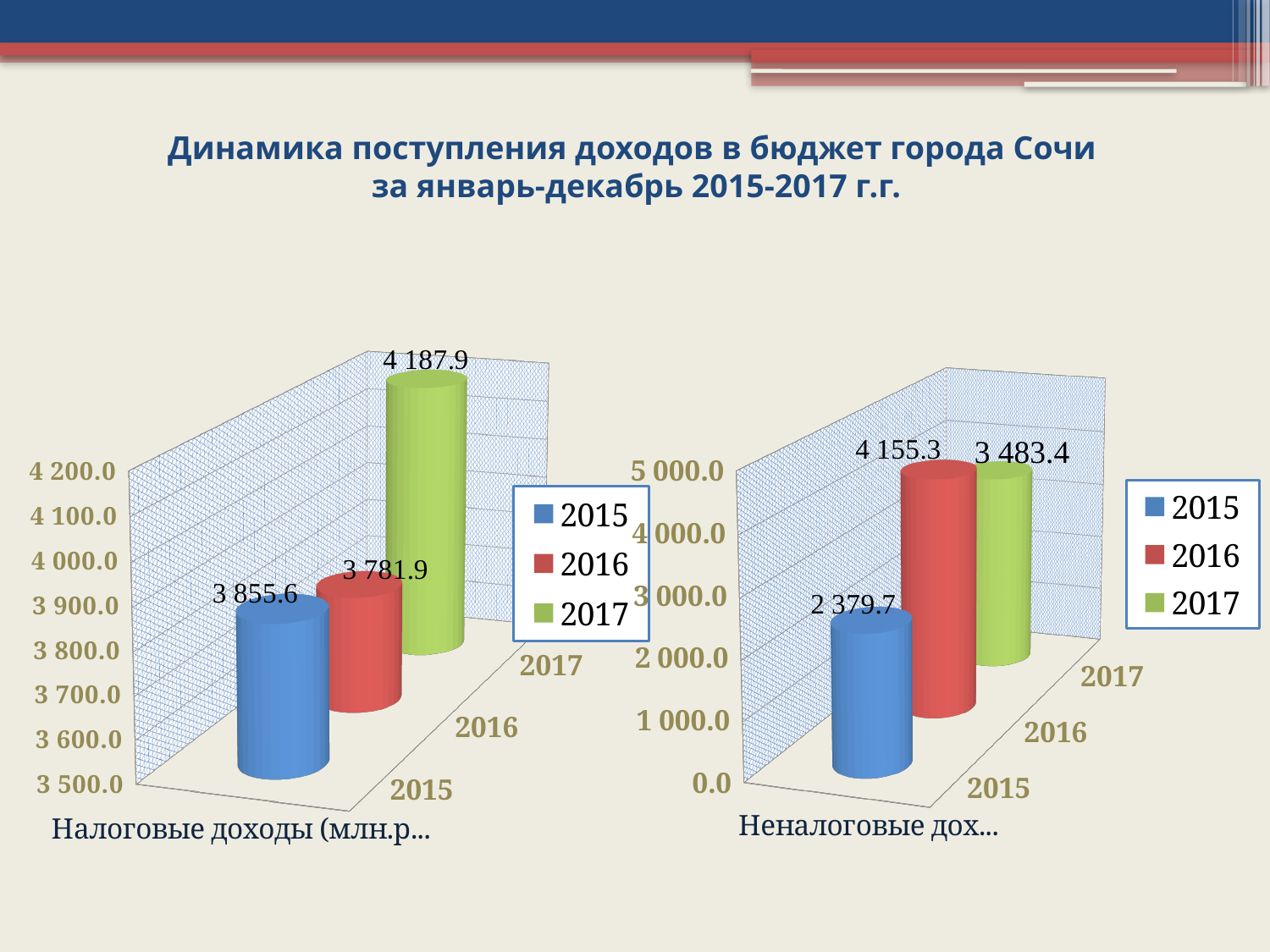
On the left chart (Налоговые доходы), what is the difference between the 2017 and 2015 values? 332.3 On the left chart (Налоговые доходы), which year has the highest value? 2017 On the right chart (Неналоговые доходы), what is the value for 2017? 3 483.4 On the left chart (Налоговые доходы), what is the value for 2017? 4 187.9 On the right chart (Неналоговые доходы), what is the value for 2015? 2 379.7 On the right chart (Неналоговые доходы), which year has the highest value? 2016 On the right chart (Неналоговые доходы), what is the difference between the 2016 and 2015 values? 1 775.6 What kind of chart is the right chart (Неналоговые доходы)? Bar chart On the left chart (Налоговые доходы), what is the value for 2016? 3 781.9 On the left chart (Налоговые доходы), which year has the lowest value? 2016 On the right chart (Неналоговые доходы), which is larger, the value for 2016 or the value for 2017? 2016 How many series does the legend of the left chart list? 3